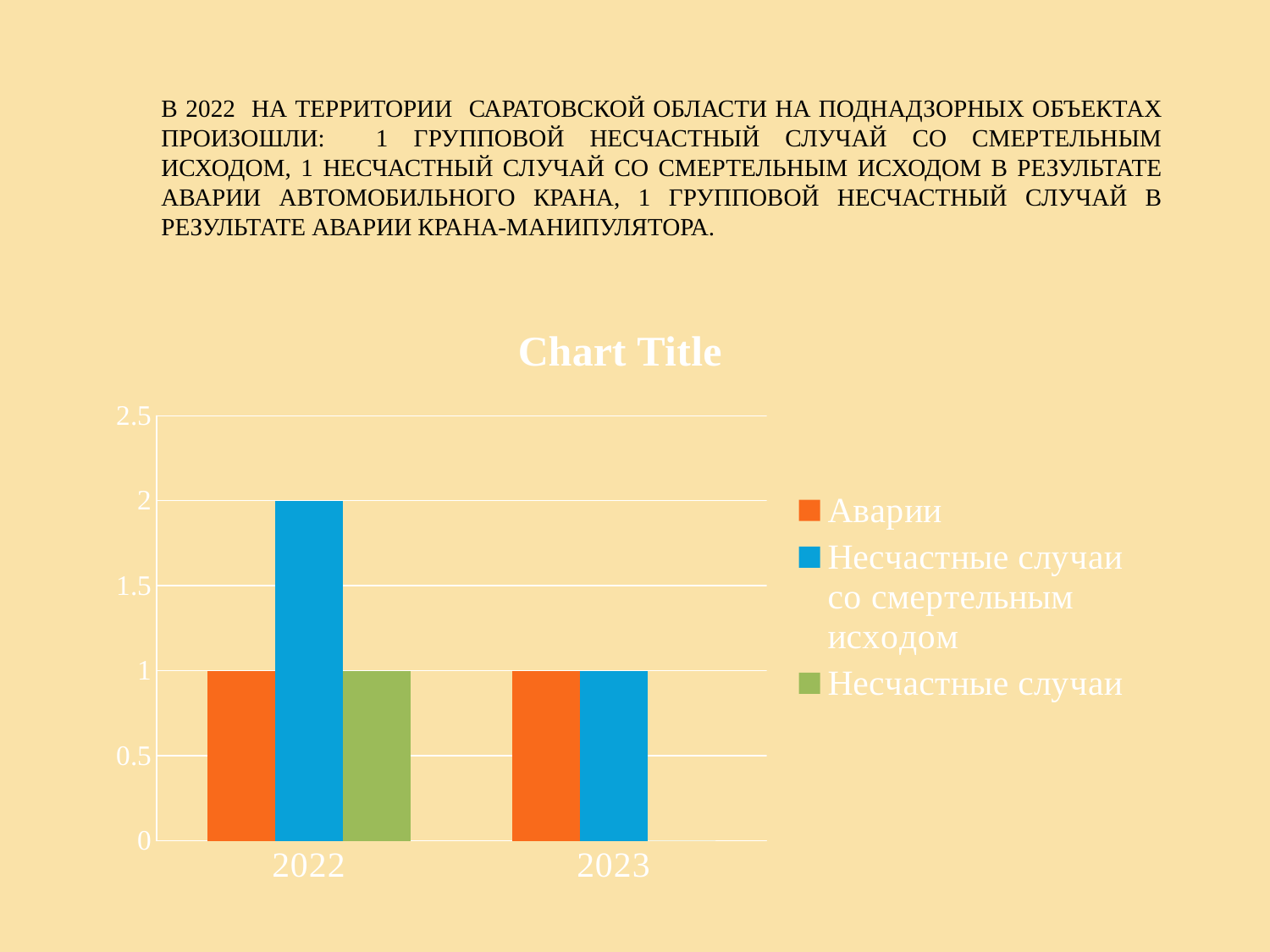
What is the difference between the value for Несчастные случаи со смертельным исходом in 2022 and in 2023? 1 What kind of chart is shown on the slide? bar chart Is the value for Несчастные случаи со смертельным исходом in 2022 greater or less than 1.5? greater What is the value for Несчастные случаи in 2022? 1 What colour are the bars for Аварии? orange How many categories are shown on the x axis? 2 How many series does the legend list? 3 What is the value for Аварии in 2022? 1 What is the value for Аварии in 2023? 1 What is the value for Несчастные случаи со смертельным исходом in 2022? 2 What is the value for Несчастные случаи со смертельным исходом in 2023? 1 Which series has the highest value in 2022? Несчастные случаи со смертельным исходом